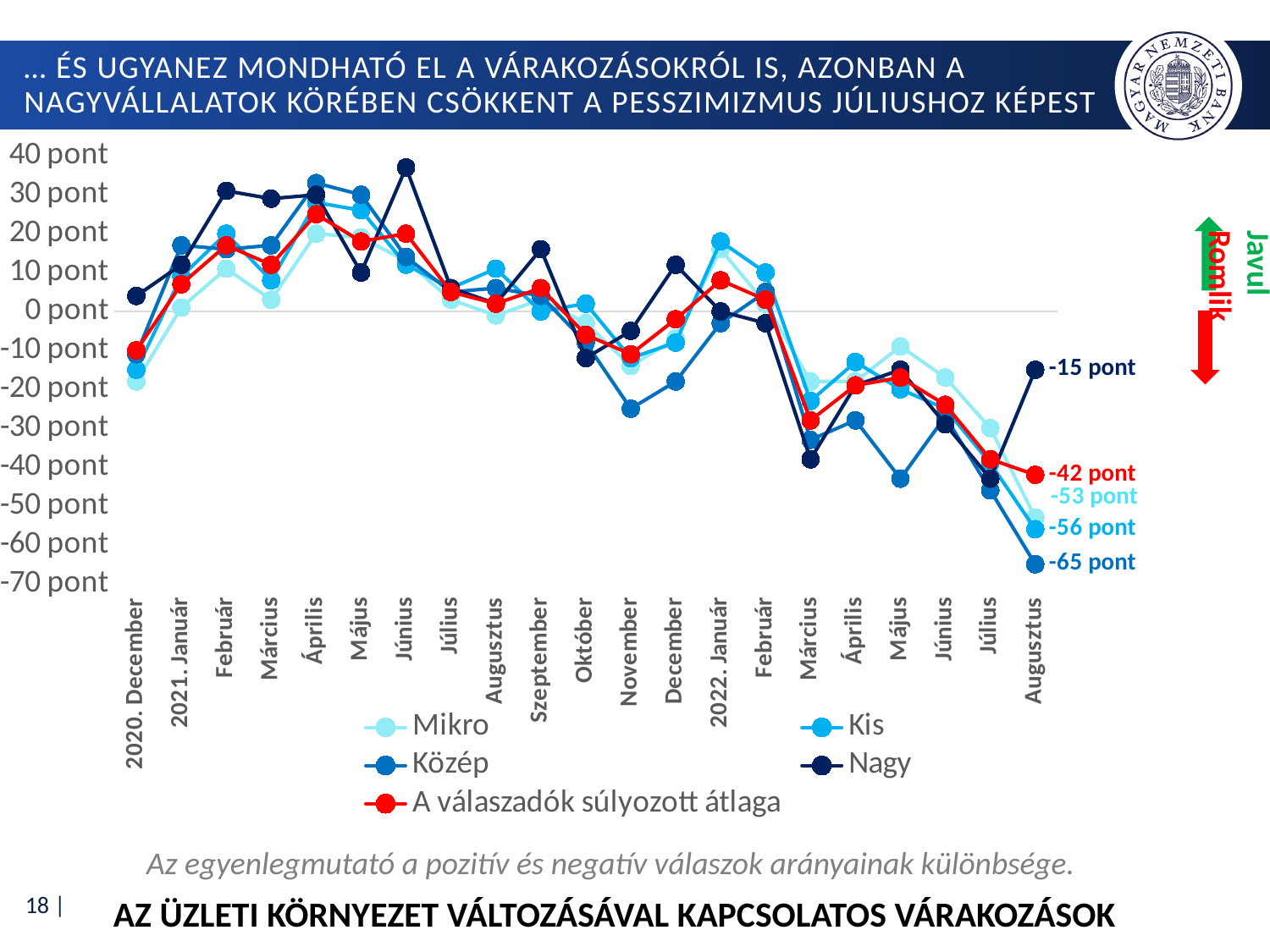
What is the value of the Kis series in Augusztus (2022)? -56 pont What is the value of the Mikro series in Augusztus (2022)? -53 pont Which series has the lowest value in Augusztus (2022)? Közép What is the value of 'A válaszadók súlyozott átlaga' in Augusztus (2022)? -42 pont What is the value of the Közép series in Augusztus (2022)? -65 pont How many series does the legend list? 5 How many months are plotted along the x axis? 21 Is the value of the Nagy series in 2021 Június greater or less than 30 pont? greater What is the difference between the Nagy and Közép values in Augusztus (2022)? 50 pont What kind of chart is shown on the slide? line chart What is the value of the Nagy series in Augusztus (2022)? -15 pont Which series has the highest value in Augusztus (2022)? Nagy